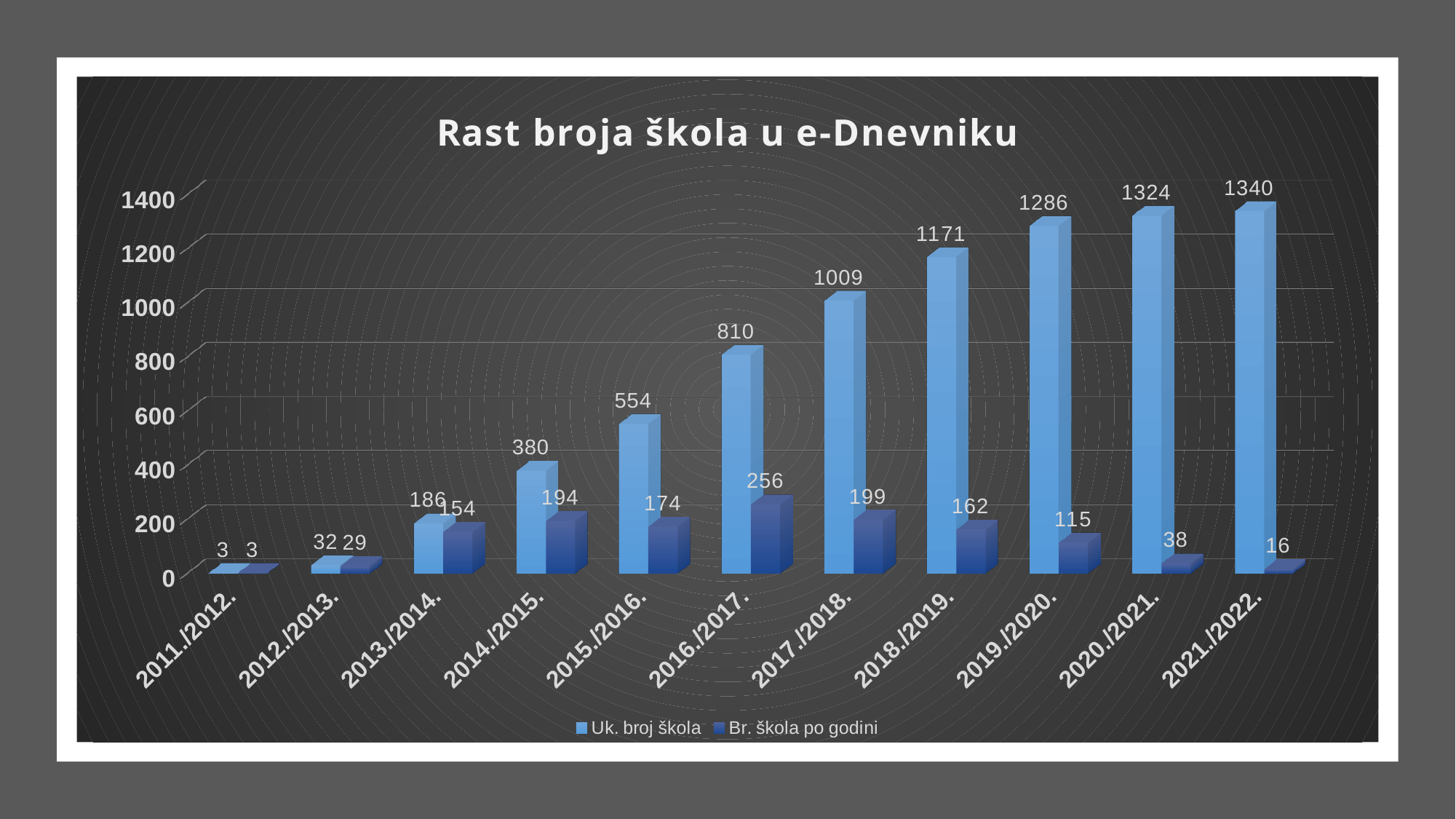
How many series does the legend list? 2 Which school year has the lowest value for "Uk. broj škola"? 2011./2012. What is the value of "Uk. broj škola" for 2016./2017.? 810 Which school year has the highest value for "Br. škola po godini"? 2016./2017. How many school years are shown on the x axis? 11 What is the value of "Br. škola po godini" for 2019./2020.? 115 What is the title of the chart? Rast broja škola u e-Dnevniku Is the value of "Uk. broj škola" for 2018./2019. greater or less than 1000? greater Does the value of "Uk. broj škola" rise or fall from 2011./2012. to 2021./2022.? rise What kind of chart is shown on the slide? bar chart What is the difference between "Uk. broj škola" in 2021./2022. and in 2020./2021.? 16 Which is larger: "Br. škola po godini" in 2014./2015. or in 2017./2018.? 2017./2018.